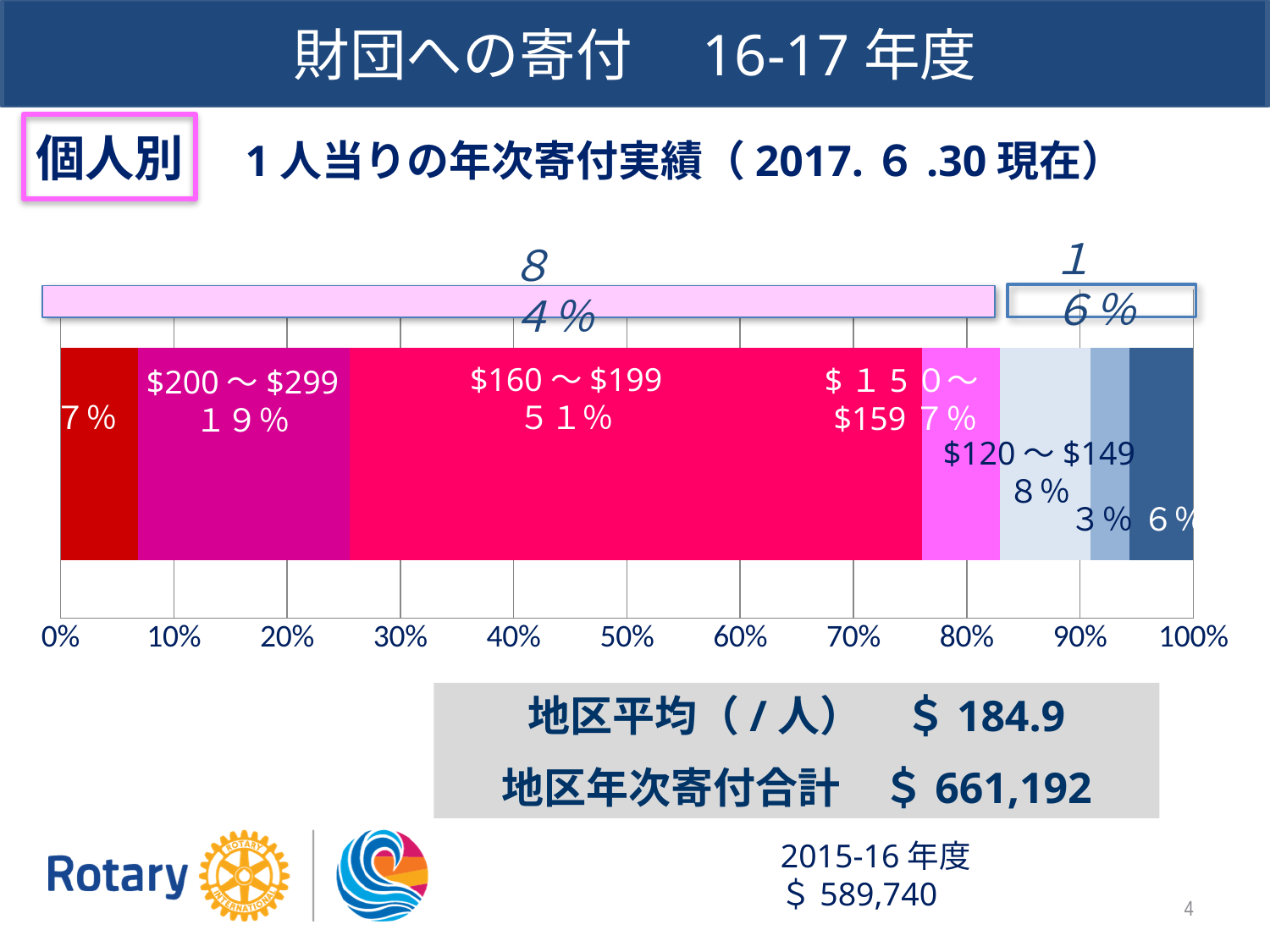
What percentage is shown for the $200～$299 segment? 19% What percentage is shown for the $120～$149 segment? 8% Which dollar range has the largest share of the stacked bar? $160～$199 What is the combined share of the $200～$299 and $160～$199 segments? 70% What percentage of the stacked bar is the $160～$199 segment? 51% Which segment is larger, $200～$299 or $120～$149? $200～$299 What percentage is shown for the $150～$159 segment? 7% How many percentage points larger is the $160～$199 segment than the $200～$299 segment? 32 percentage points What kind of chart is shown on the slide? Stacked bar chart Among the labeled dollar ranges, which has the smallest share? $150～$159 What is the highest value shown on the horizontal axis? 100% How many segments make up the stacked bar? 7